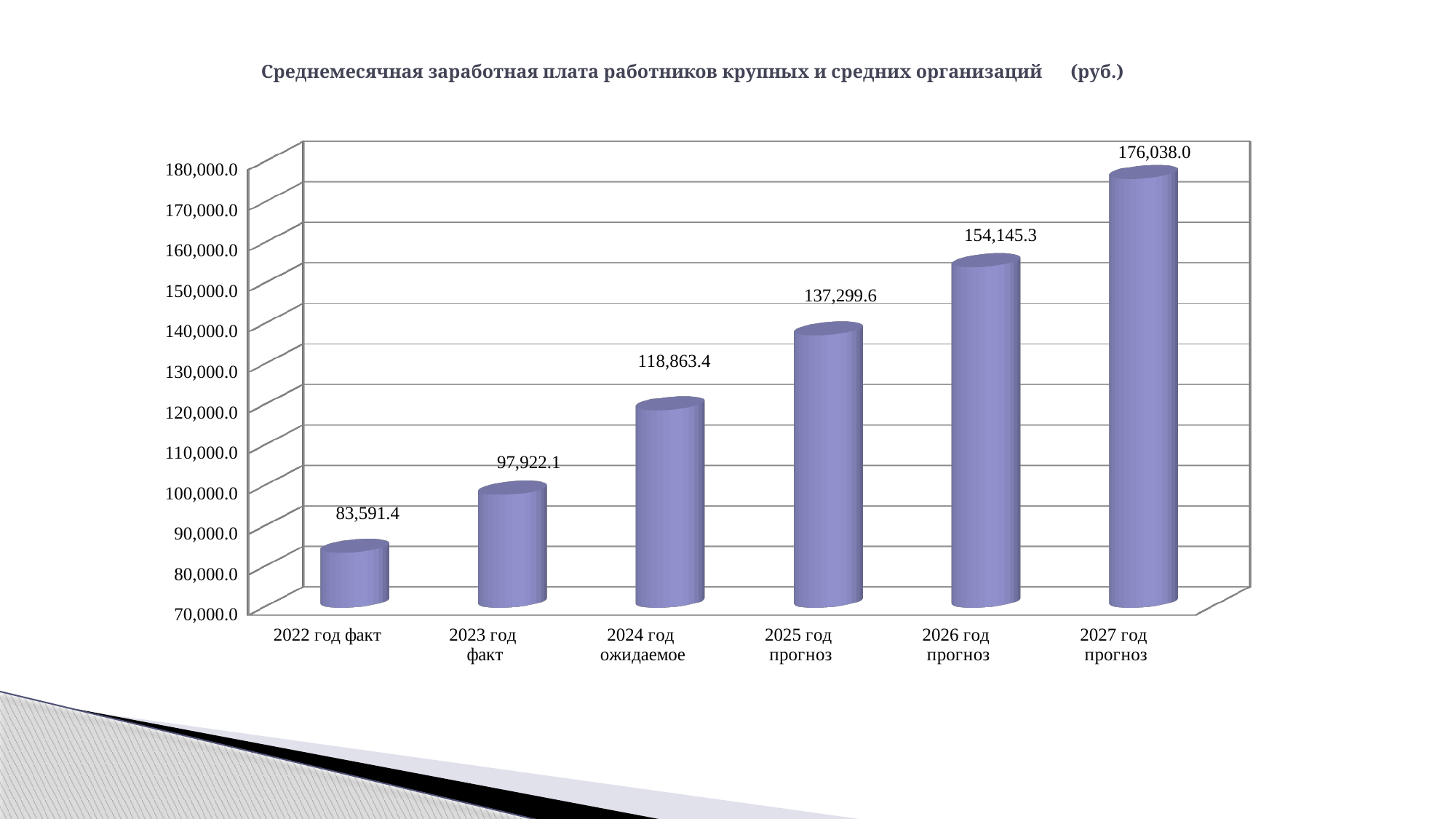
Is the value for 2026 год прогноз greater or less than 150,000.0? greater Which category has the highest value? 2027 год прогноз Which category has the lowest value? 2022 год факт What is the difference between the values for 2027 год прогноз and 2026 год прогноз? 21,892.7 What is the value for 2027 год прогноз? 176,038.0 What is the value for 2025 год прогноз? 137,299.6 What is the value for 2023 год факт? 97,922.1 What is the difference between the values for 2023 год факт and 2022 год факт? 14,330.7 What kind of chart is shown on the slide? bar chart How many categories are shown on the x axis? 6 Do the values rise or fall from 2022 год факт to 2027 год прогноз? rise Which is larger, the value for 2024 год ожидаемое or the value for 2025 год прогноз? 2025 год прогноз